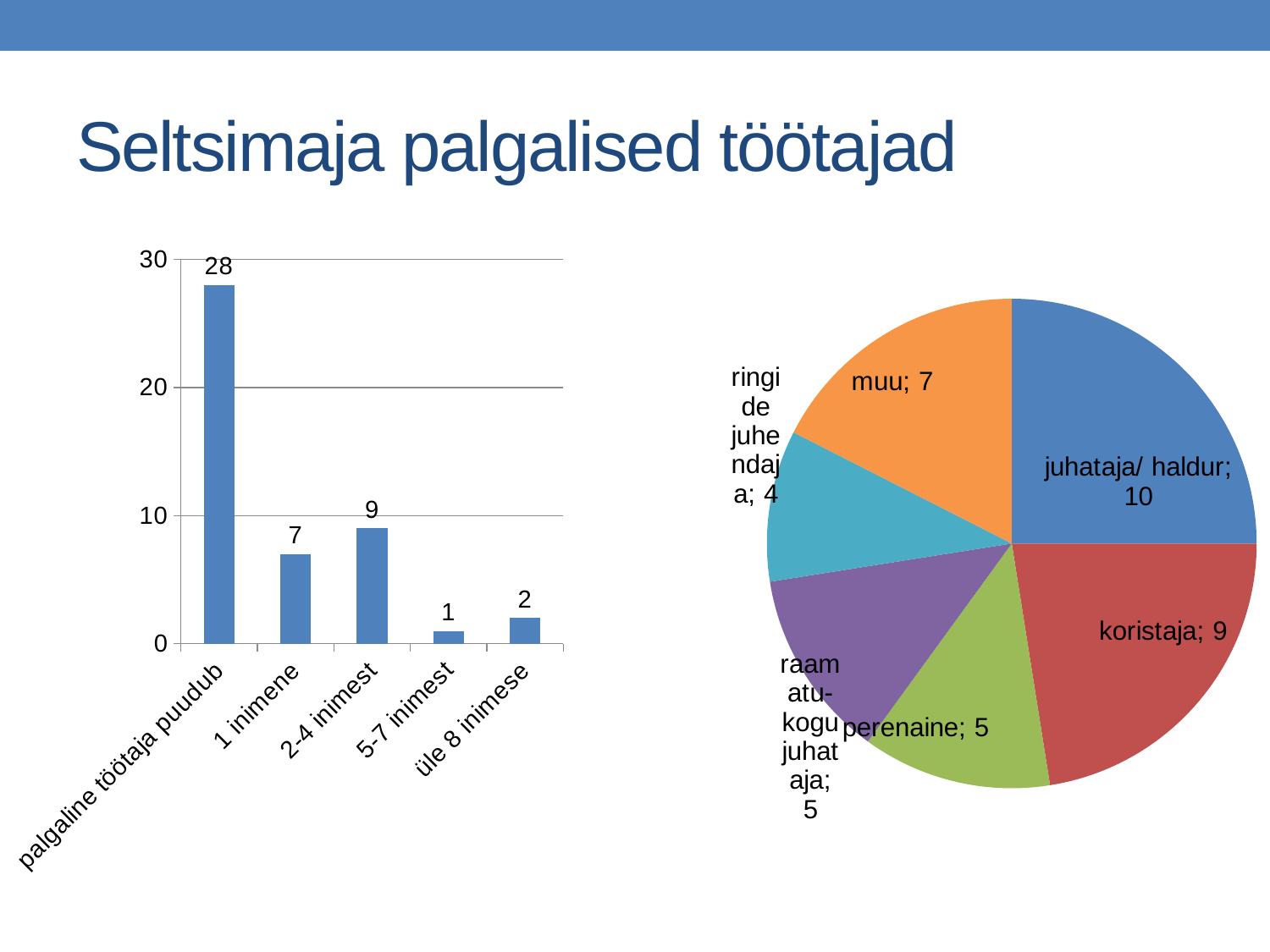
In the pie chart on the right, how many slices are there? 6 In the bar chart on the left, what is the value for "2-4 inimest"? 9 What kind of chart is the chart on the left of the slide? bar chart In the pie chart on the right, which is larger: "perenaine" or "muu"? muu In the pie chart on the right, which slice is the largest? juhataja/ haldur In the pie chart on the right, what is the value for "koristaja"? 9 In the bar chart on the left, what is the difference between the values for "2-4 inimest" and "1 inimene"? 2 In the bar chart on the left, which category has the highest value? palgaline töötaja puudub In the pie chart on the right, what is the value for "muu"? 7 In the bar chart on the left, how many categories are shown on the x axis? 5 In the bar chart on the left, what is the value for "palgaline töötaja puudub"? 28 In the bar chart on the left, which category has the lowest value? 5-7 inimest